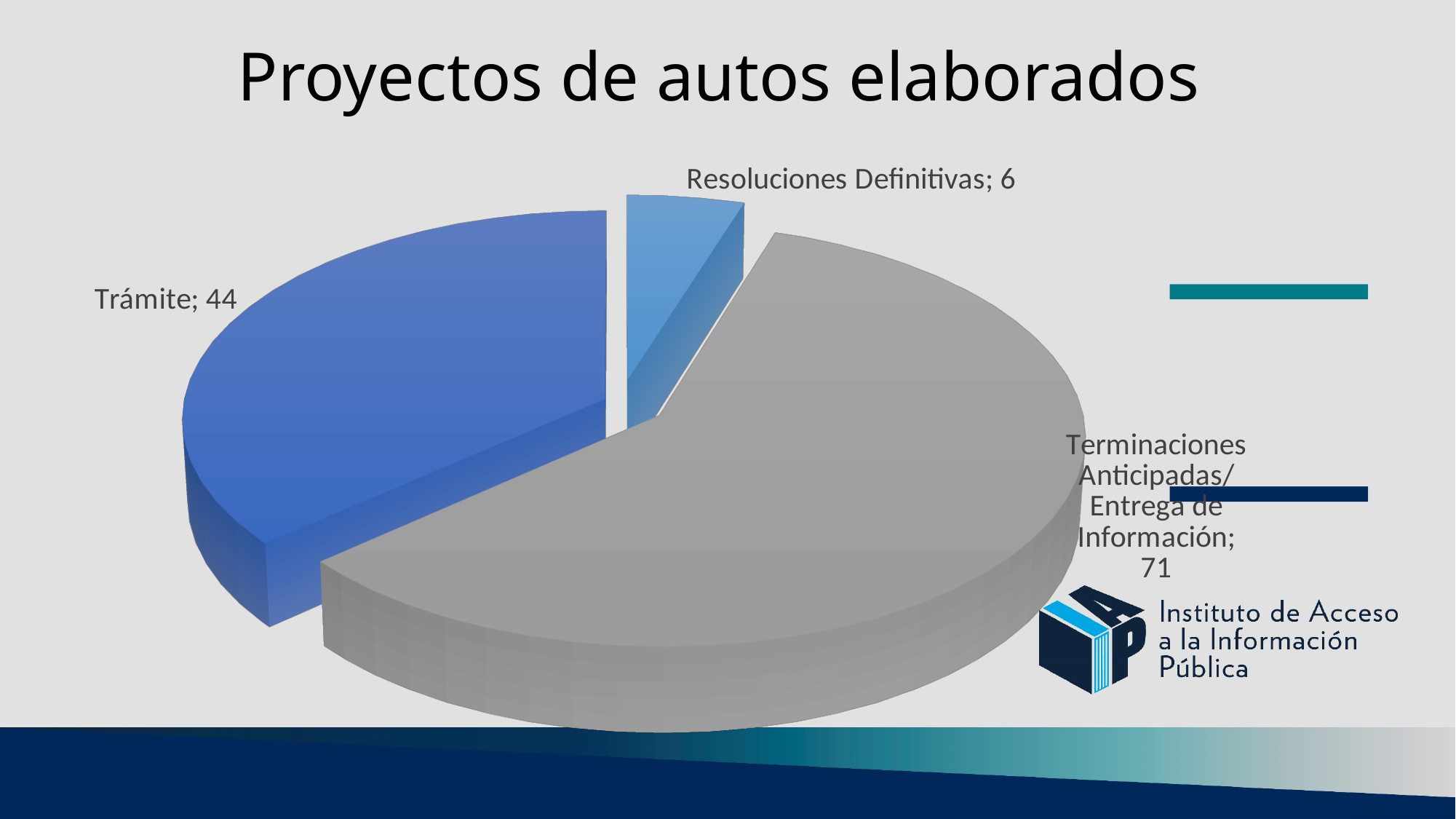
What is the value for Trámite? 44 What is the title of the chart? Proyectos de autos elaborados What is the value for Resoluciones Definitivas? 6 How many slices does the pie chart have? 3 What is the total of all three slices? 121 What is the difference between the values for Terminaciones Anticipadas/Entrega de Información and Trámite? 27 What is the value for Terminaciones Anticipadas/Entrega de Información? 71 What type of chart is shown on the slide? pie chart Which is larger, the value for Trámite or the value for Resoluciones Definitivas? Trámite What colour is the Trámite slice? blue Which category has the smallest slice? Resoluciones Definitivas Which category has the largest slice? Terminaciones Anticipadas/Entrega de Información